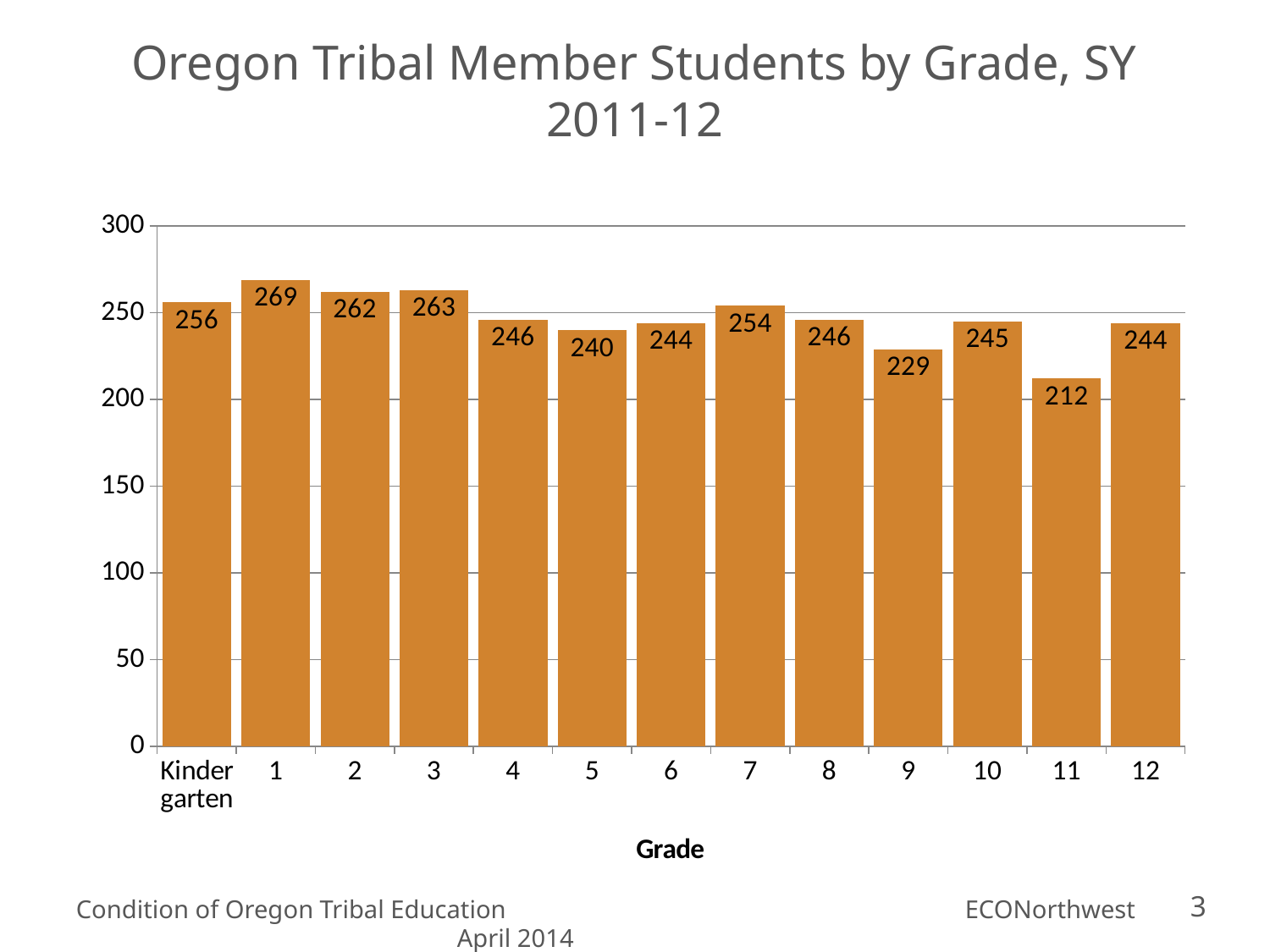
Is the value for grade 9 greater or less than 250? less How many tribal member students are in grade 1? 269 What kind of chart is shown on the slide? Bar chart Which grade has the lowest number of students? 11 How many students are in grade 11? 212 Which has more students, grade 3 or grade 9? Grade 3 What is the difference between the values for grade 2 and grade 5? 22 How many grade categories are shown on the x axis? 13 What is the difference between the number of students in grade 1 and grade 11? 57 What is the value for Kindergarten? 256 Which grade has the highest number of students? 1 What is the x-axis title of the chart? Grade